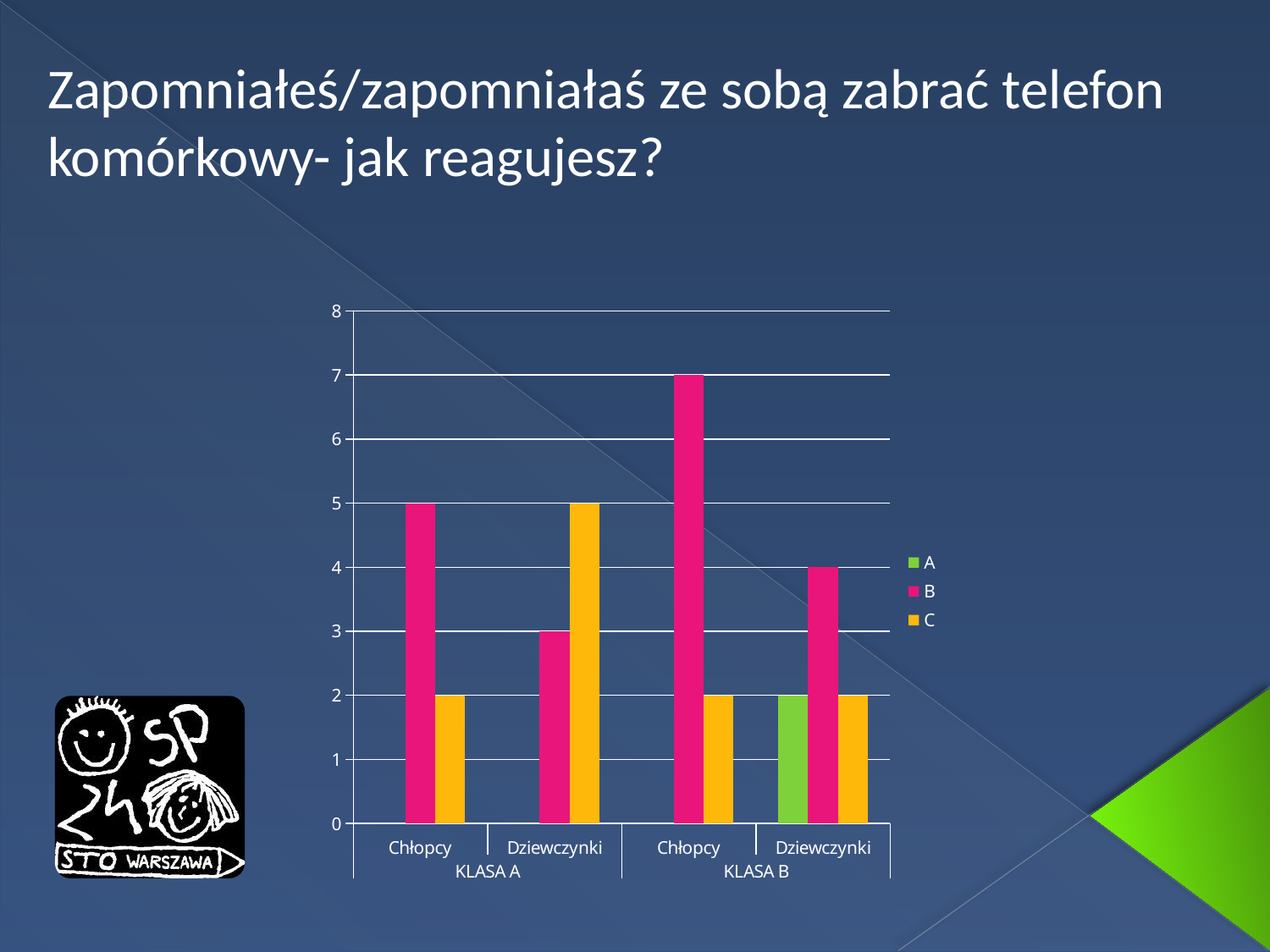
What is the value of series B for Chłopcy in KLASA A? 5 Which group has the lowest value for series B? Dziewczynki in KLASA A Which group has the highest value for series B? Chłopcy in KLASA B What is the value of series B for Chłopcy in KLASA B? 7 For Dziewczynki in KLASA A, which is larger: series B or series C? C What type of chart is shown on the slide? bar chart Which group is the only one with a bar for series A? Dziewczynki in KLASA B What is the value of series A for Dziewczynki in KLASA B? 2 What colour are the bars for series B? pink What is the value of series C for Dziewczynki in KLASA A? 5 How many series does the legend list? 3 What is the difference between series B for Chłopcy in KLASA B and series B for Dziewczynki in KLASA B? 3